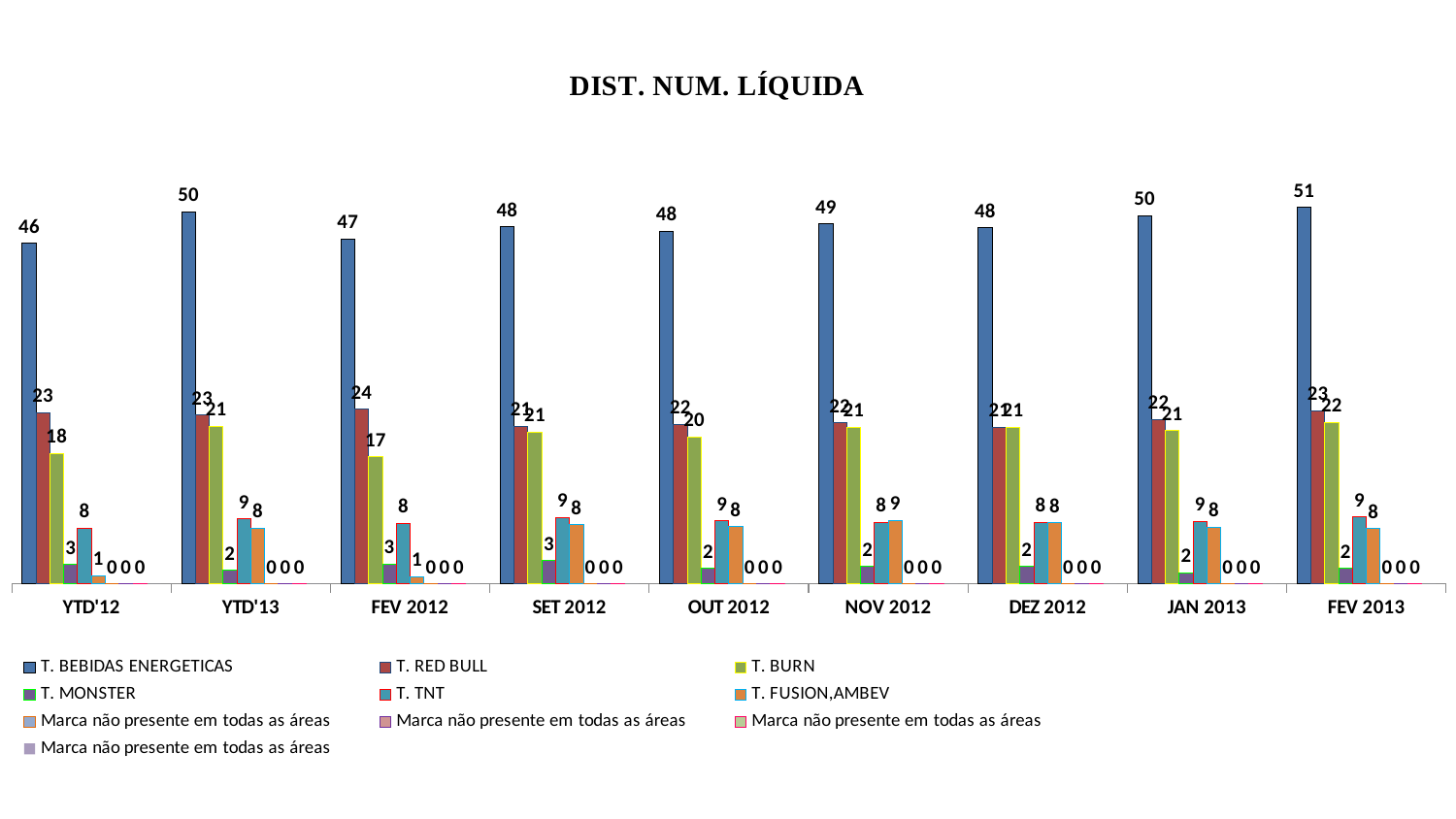
What is the difference between the T. BEBIDAS ENERGETICAS values for FEV 2013 and YTD'12? 5 What is the value of T. BEBIDAS ENERGETICAS for YTD'13? 50 What is the value of T. BEBIDAS ENERGETICAS for FEV 2013? 51 What is the difference between the T. BEBIDAS ENERGETICAS values for YTD'13 and YTD'12? 4 Which category has the lowest value for T. BEBIDAS ENERGETICAS? YTD'12 What type of chart is shown on the slide? Bar chart How many categories are shown on the x axis? 9 What is the value of T. RED BULL for FEV 2012? 24 In YTD'12, which is larger: T. RED BULL or T. BURN? T. RED BULL Which category has the highest value for T. BEBIDAS ENERGETICAS? FEV 2013 How many entries does the legend list? 10 What is the value of T. BURN for YTD'12? 18